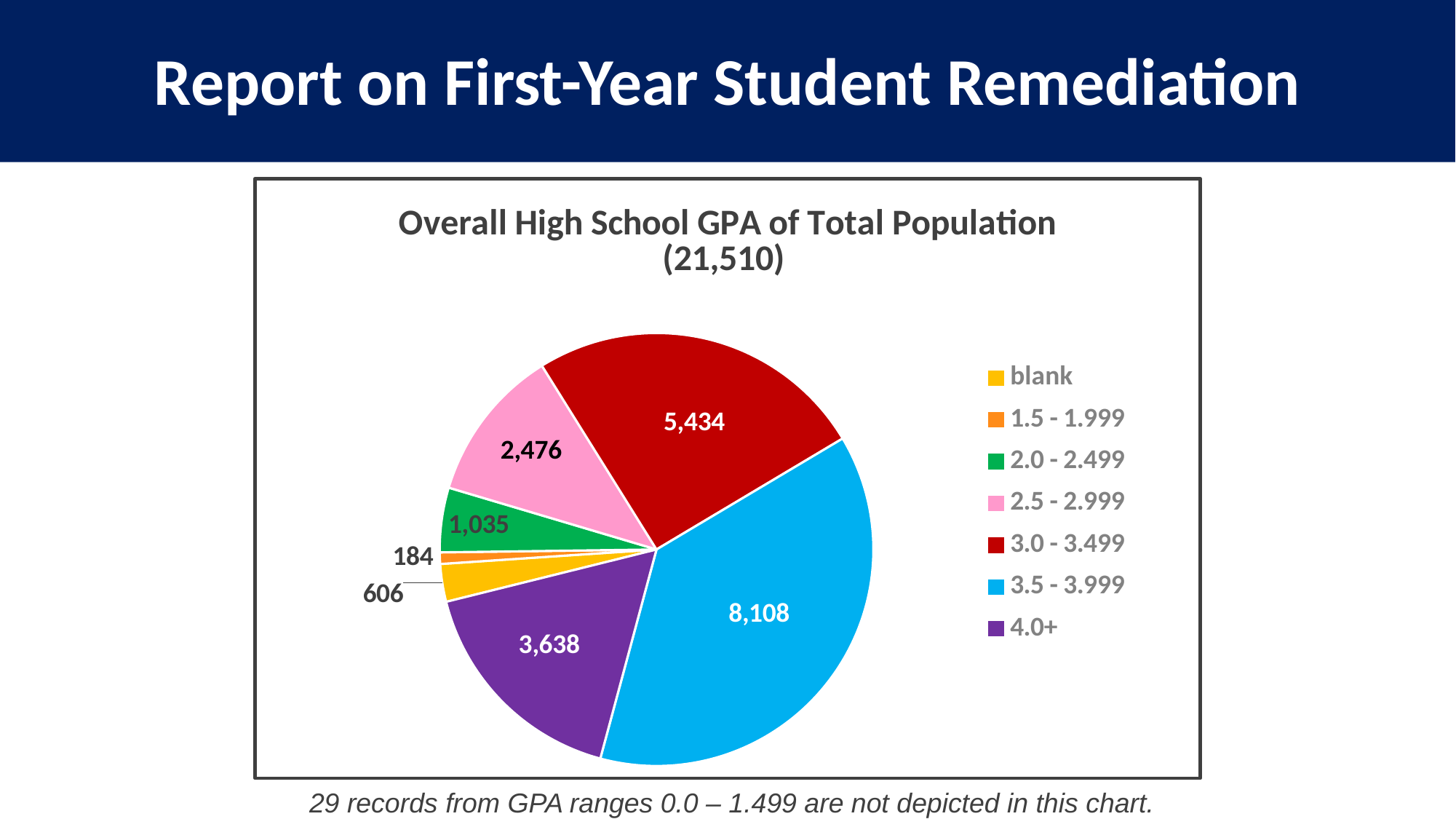
What is the value for the 1.5 - 1.999 GPA range? 184 What is the value for the 3.5 - 3.999 GPA range? 8,108 Which GPA range has the largest slice of the pie? 3.5 - 3.999 Which category has the smallest slice of the pie? 1.5 - 1.999 What is the title of the chart? Overall High School GPA of Total Population (21,510) What is the value for the blank category? 606 What is the difference between the 3.5 - 3.999 and 3.0 - 3.499 values? 2,674 Which is larger, the value for 4.0+ or the value for 2.5 - 2.999? 4.0+ How many categories does the legend list? 7 What is the value for the 4.0+ GPA range? 3,638 What is the value for the 3.0 - 3.499 GPA range? 5,434 What type of chart is shown on the slide? pie chart